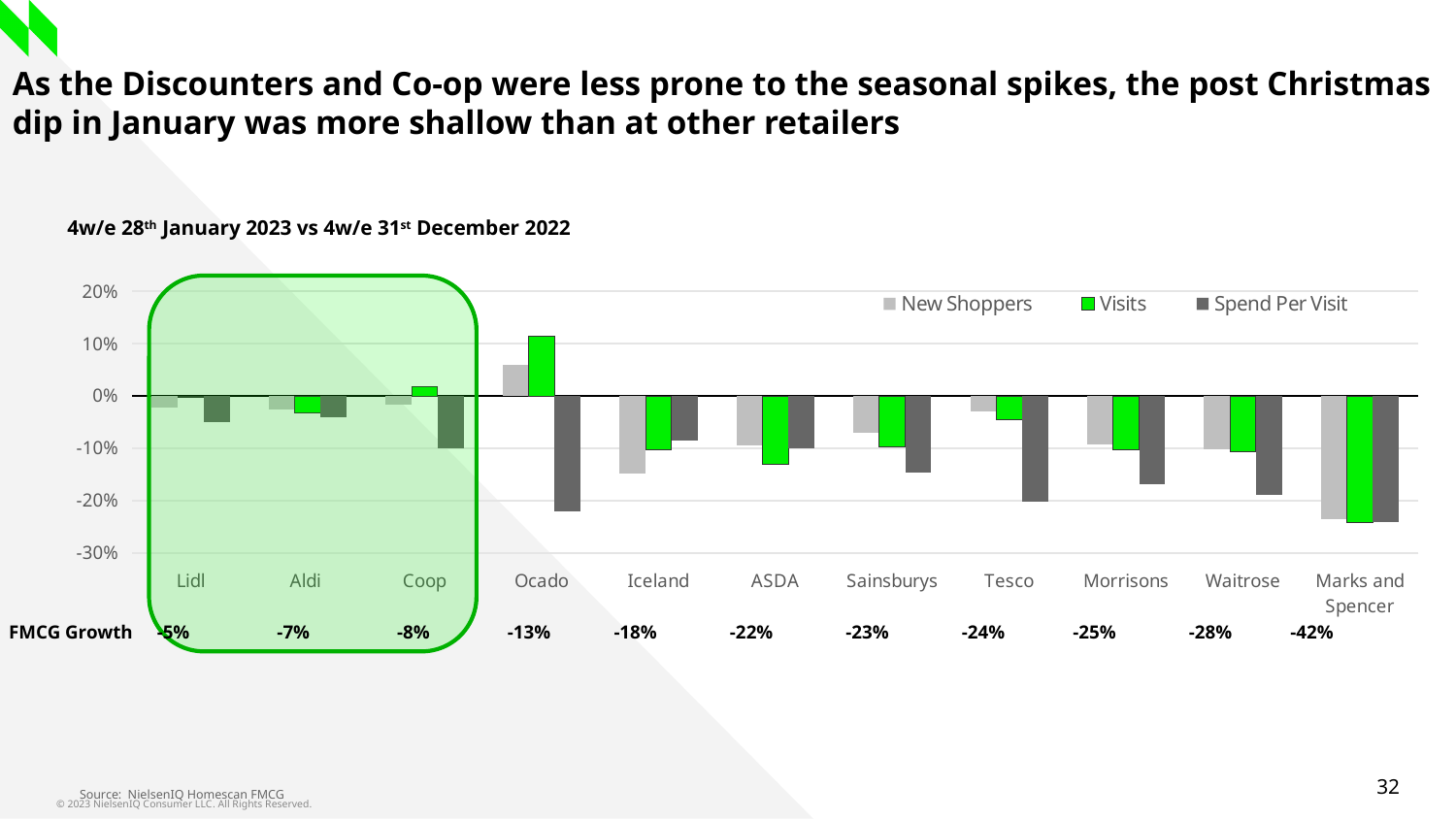
Which retailer has the lowest Visits value in the chart? Marks and Spencer Do the FMCG Growth values rise or fall moving from Lidl on the left to Marks and Spencer on the right? fall What is the FMCG Growth value shown for Marks and Spencer? -42% How many series does the chart's legend list? 3 What is the FMCG Growth value shown for Tesco? -24% Is the Spend Per Visit value for Ocado greater or less than -20%? less What is the difference between the FMCG Growth values for Waitrose and Coop? 20 percentage points What kind of chart is shown on the slide? bar chart Which retailer has the highest Visits value in the chart? Ocado How many retailers are shown along the x axis of the chart? 11 Is the New Shoppers value for Iceland greater or less than -10%? less What is the FMCG Growth value shown for Lidl? -5%